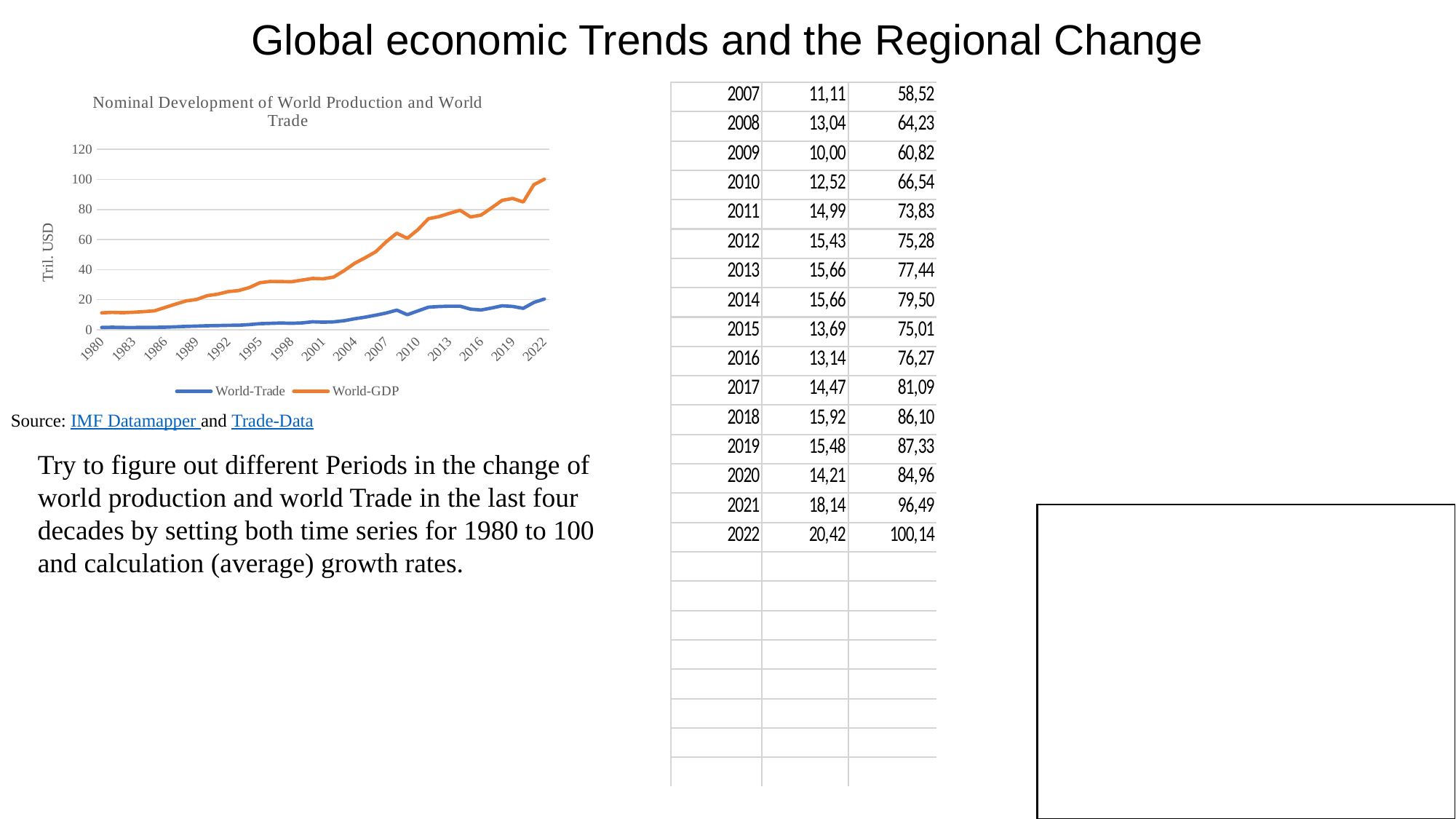
What is the label on the chart's vertical axis? Tril. USD How many series does the chart's legend list? 2 What kind of chart is shown on the slide? line chart Which series stays higher than the other across the whole period shown? World-GDP What are the two series named in the chart's legend? World-Trade and World-GDP Is the value for World-Trade in 2022 greater or less than 40? less Is the value for World-GDP in 2022 greater or less than 80? greater How many year labels are shown on the chart's x axis? 15 In 2022, which series has the larger value, World-Trade or World-GDP? World-GDP Does the World-GDP line generally rise or fall from 1980 to 2022? rise Is the value for World-GDP in 2007 greater or less than 40? greater